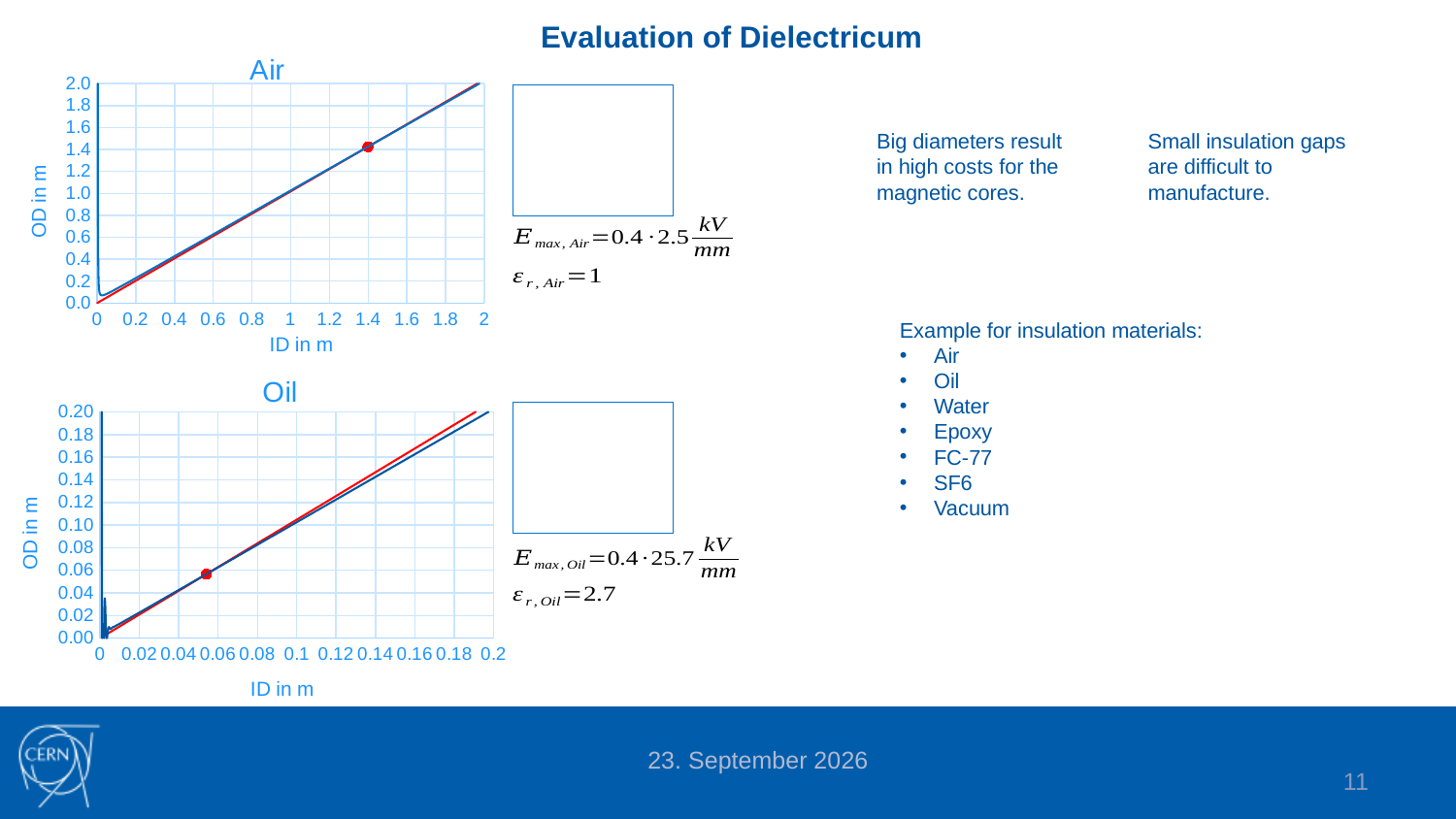
In the chart titled "Air", is the OD value at ID = 1.0 greater or less than 1.4? less How many charts are shown on the slide? 2 What is the maximum value shown on the y axis of the chart titled "Oil"? 0.20 What kind of chart is the chart titled "Air"? line chart In the chart titled "Air", do the plotted values rise or fall as ID increases along the x axis? rise What kind of chart is the chart titled "Oil"? line chart In the chart titled "Air", is the OD value at ID = 1.8 greater or less than 1.4? greater In the chart titled "Oil", is the OD value at ID = 0.18 greater or less than 0.14? greater In the chart titled "Oil", do the plotted values rise or fall as ID increases along the x axis? rise What is the title of the upper chart on the slide? Air What is the x-axis label of the chart titled "Oil"? ID in m